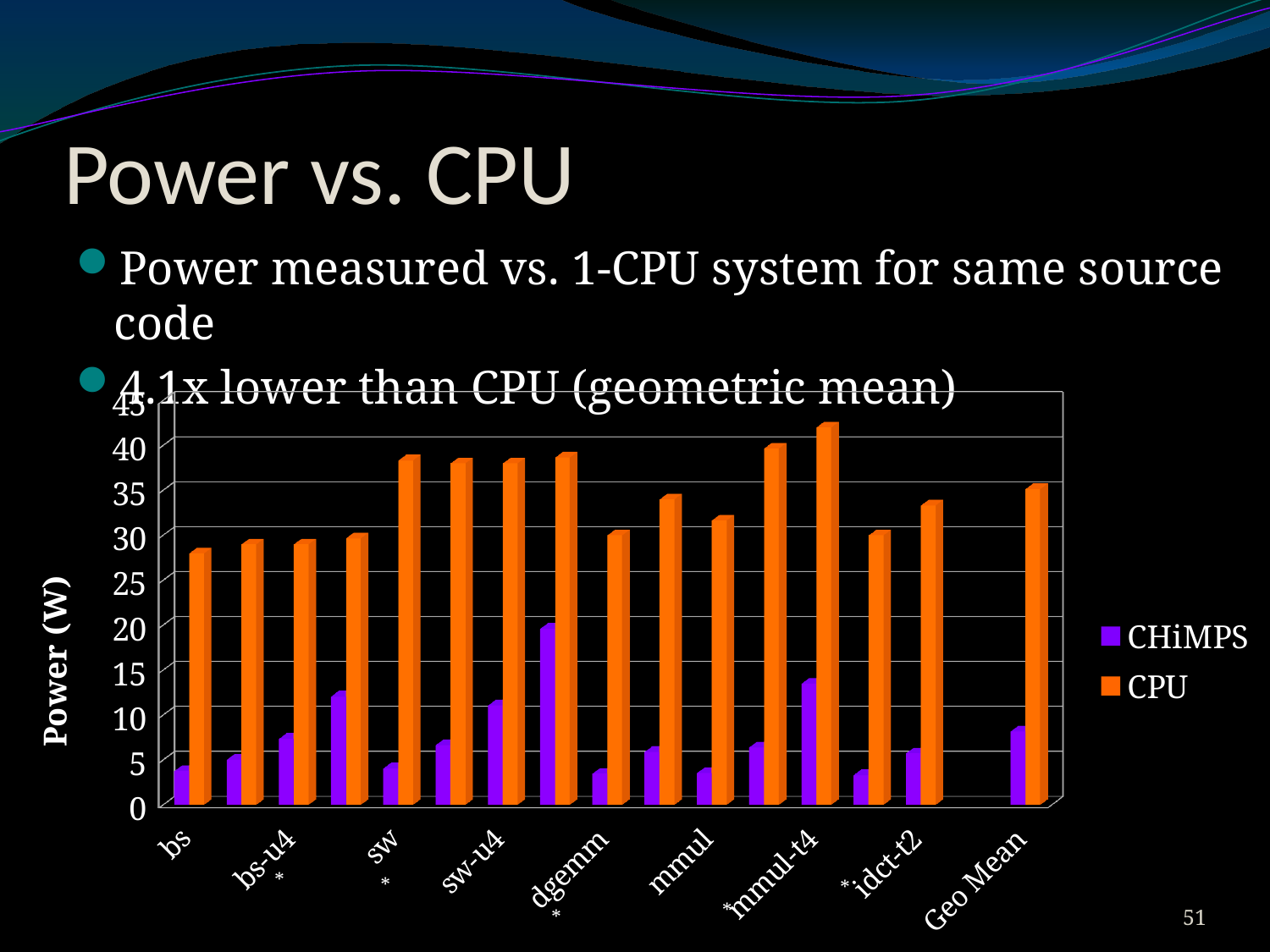
For the Geo Mean category, which series has the larger value, CHiMPS or CPU? CPU For the bs category, which series has the larger value, CHiMPS or CPU? CPU How many series does the chart's legend list? 2 Is the CHiMPS value for Geo Mean greater or less than 15? less Is the CHiMPS value for bs greater or less than 10? less What is the label of the vertical axis? Power (W) What are the two series named in the legend? CHiMPS and CPU Which series has the higher value in every category, CHiMPS or CPU? CPU What kind of chart is shown on the slide? bar chart Is the CPU value for bs greater or less than 40? less